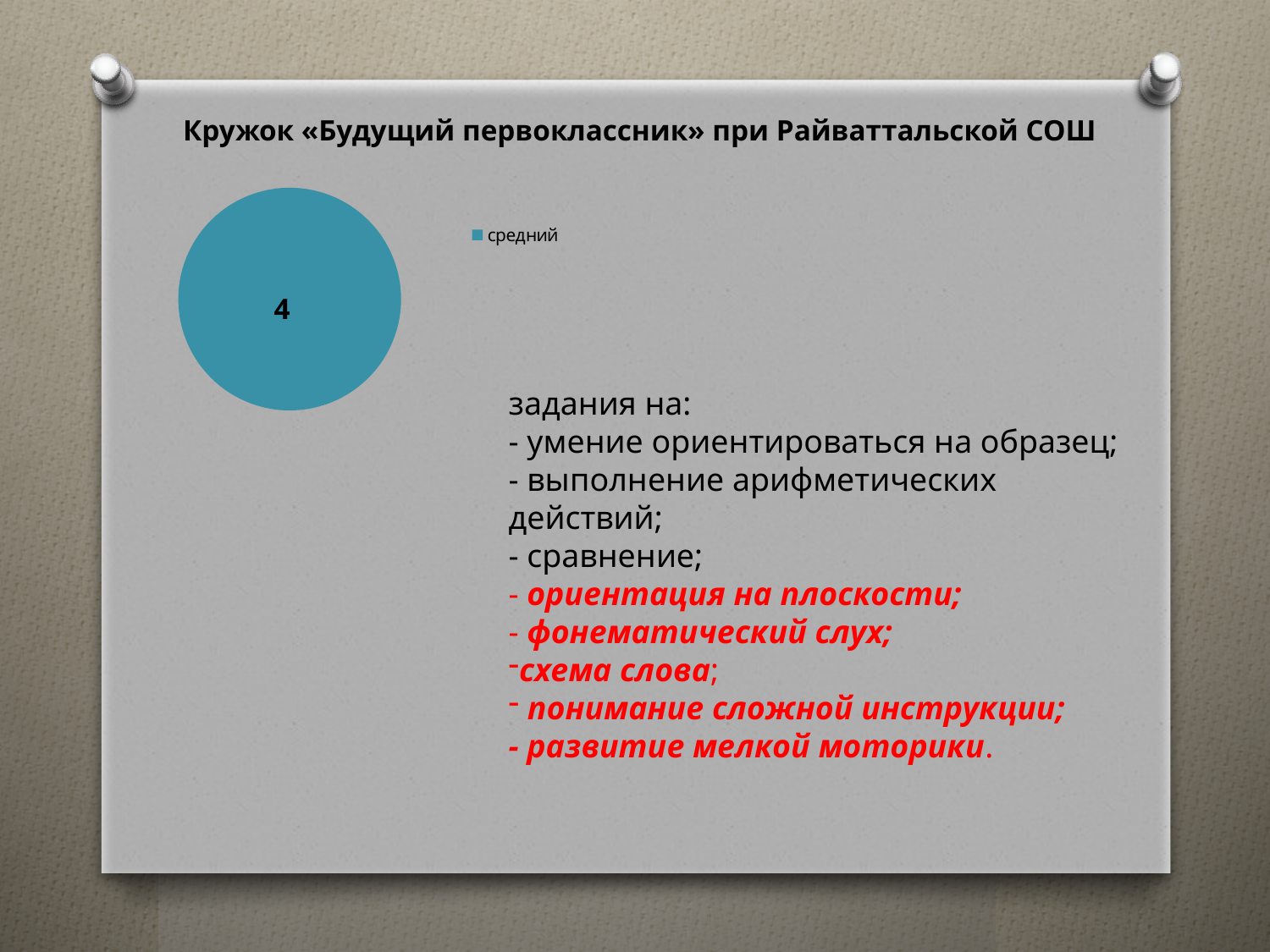
What is the name of the only category listed in the pie chart's legend? средний How many entries does the pie chart's legend list? 1 What value is shown for the "средний" slice of the pie chart? 4 What kind of chart is shown on the slide? pie chart What colour is the "средний" slice of the pie chart? teal blue What share of the pie does the "средний" slice take up? 100% How many slices does the pie chart have? 1